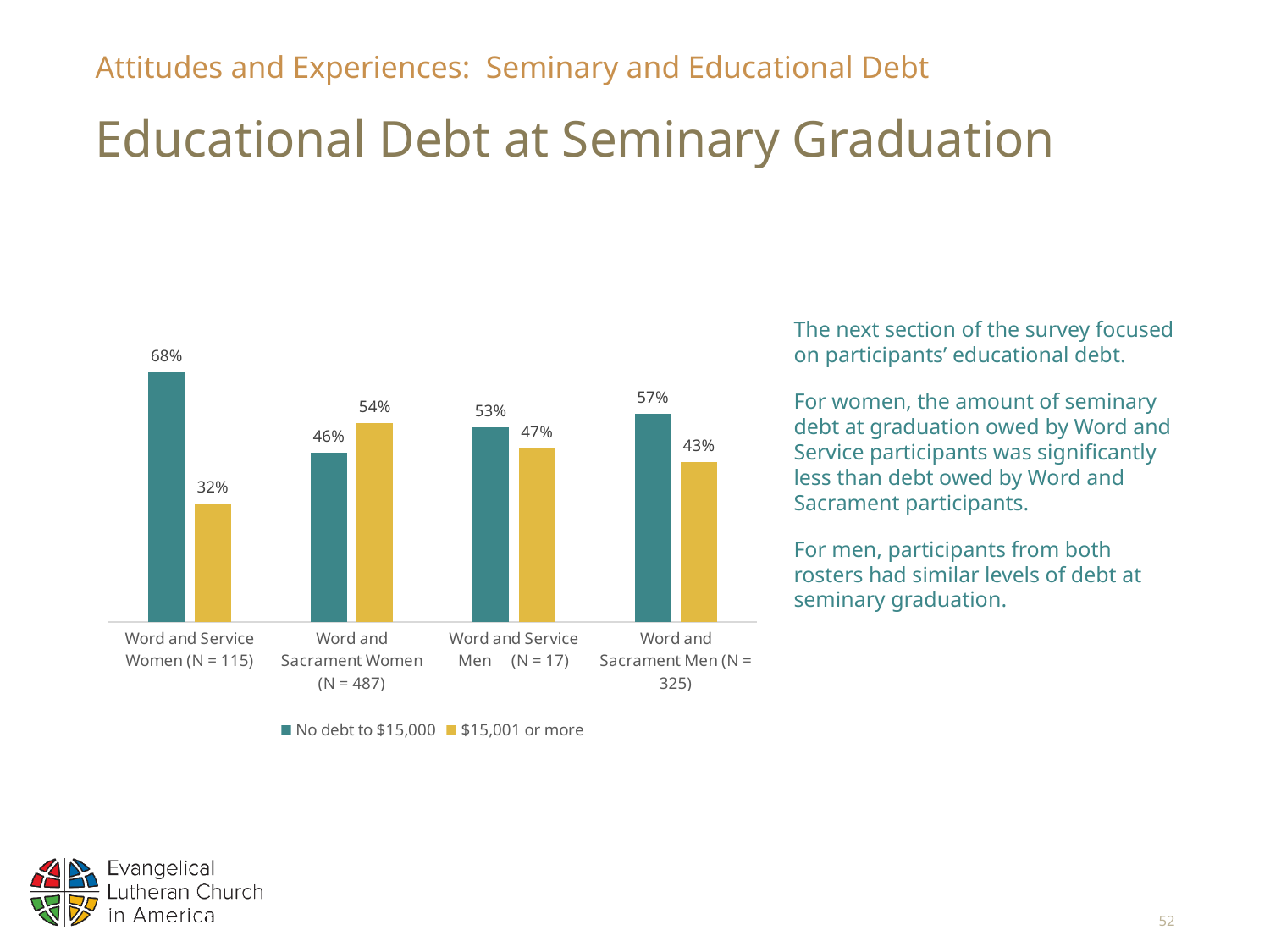
How many series does the legend list? 2 How many categories are shown on the x axis of the chart? 4 What percentage of Word and Sacrament Men (N = 325) had $15,001 or more in debt? 43% What is the value for Word and Service Men (N = 17) in the '$15,001 or more' series? 47% What is the difference between the 'No debt to $15,000' and '$15,001 or more' values for Word and Service Women (N = 115)? 36% Which category has the lowest value for the '$15,001 or more' series? Word and Service Women (N = 115) Which colour represents the '$15,001 or more' series in the chart? Yellow For Word and Sacrament Women (N = 487), which is larger: 'No debt to $15,000' or '$15,001 or more'? $15,001 or more What percentage of Word and Sacrament Women (N = 487) had $15,001 or more in debt? 54% What percentage of Word and Service Women (N = 115) had no debt to $15,000? 68% What kind of chart is shown on the slide? Bar chart Which category has the highest value for the 'No debt to $15,000' series? Word and Service Women (N = 115)